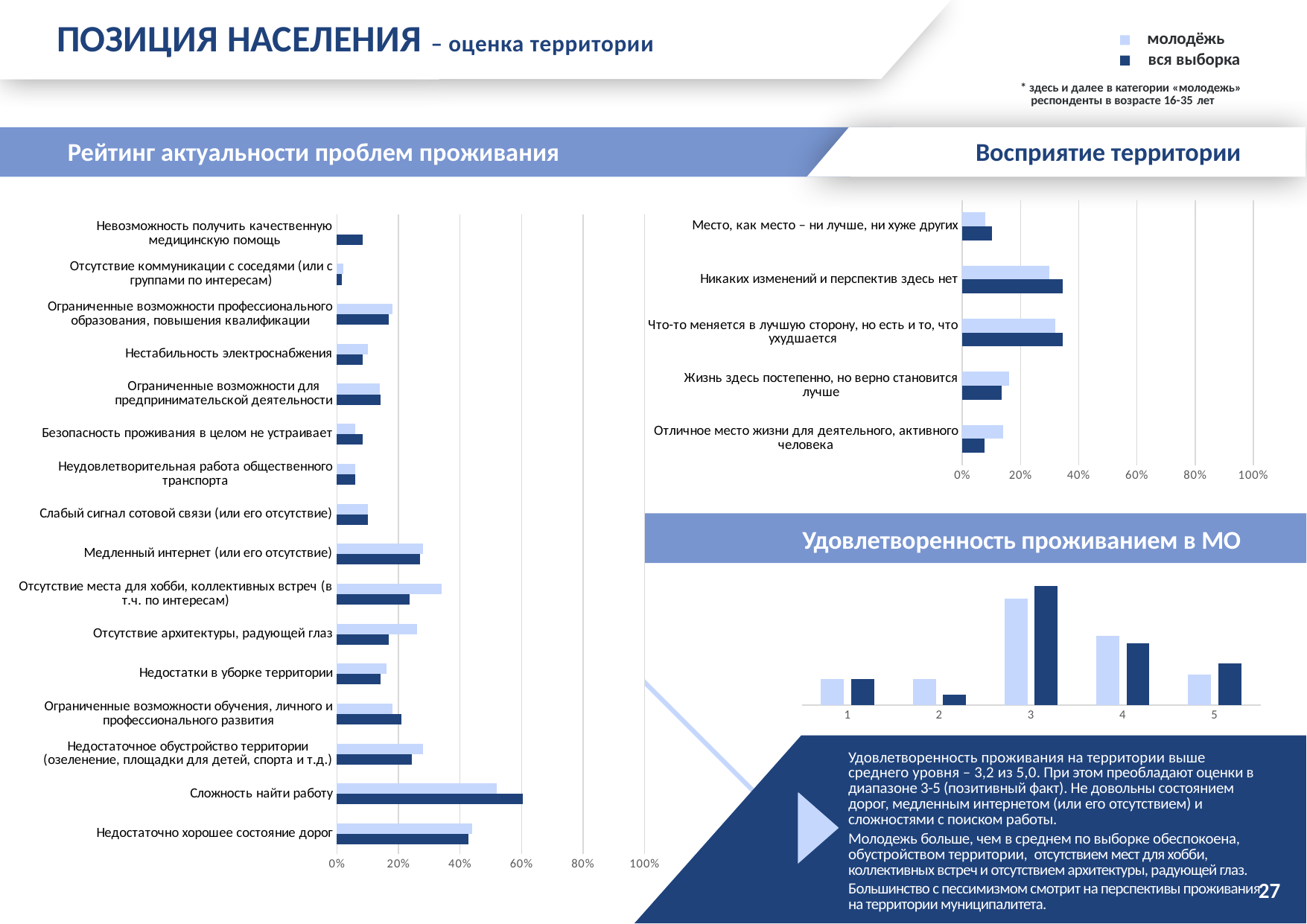
How many problem categories are shown in the 'Рейтинг актуальности проблем проживания' chart? 16 What are the two series named in the legend? молодёжь, вся выборка In the 'Рейтинг актуальности проблем проживания' chart, is the 'вся выборка' value for 'Сложность найти работу' greater or less than 40%? greater In the 'Рейтинг актуальности проблем проживания' chart, is the 'вся выборка' value for 'Невозможность получить качественную медицинскую помощь' greater or less than 20%? less In the 'Рейтинг актуальности проблем проживания' chart, for 'Отсутствие места для хобби, коллективных встреч (в т.ч. по интересам)', which series has the larger value: 'молодёжь' or 'вся выборка'? молодёжь In the 'Удовлетворенность проживанием в МО' chart, which rating has the highest value for 'вся выборка'? 3 In the 'Рейтинг актуальности проблем проживания' chart, which category has the highest value for 'вся выборка'? Сложность найти работу In the 'Восприятие территории' chart, is the 'вся выборка' value for 'Никаких изменений и перспектив здесь нет' greater or less than 20%? greater What kind of chart is 'Рейтинг актуальности проблем проживания'? bar chart In the 'Рейтинг актуальности проблем проживания' chart, which category has the lowest value for 'вся выборка'? Отсутствие коммуникации с соседями (или с группами по интересам) How many categories are shown in the 'Восприятие территории' chart? 5 How many series does the legend at the top of the slide list? 2